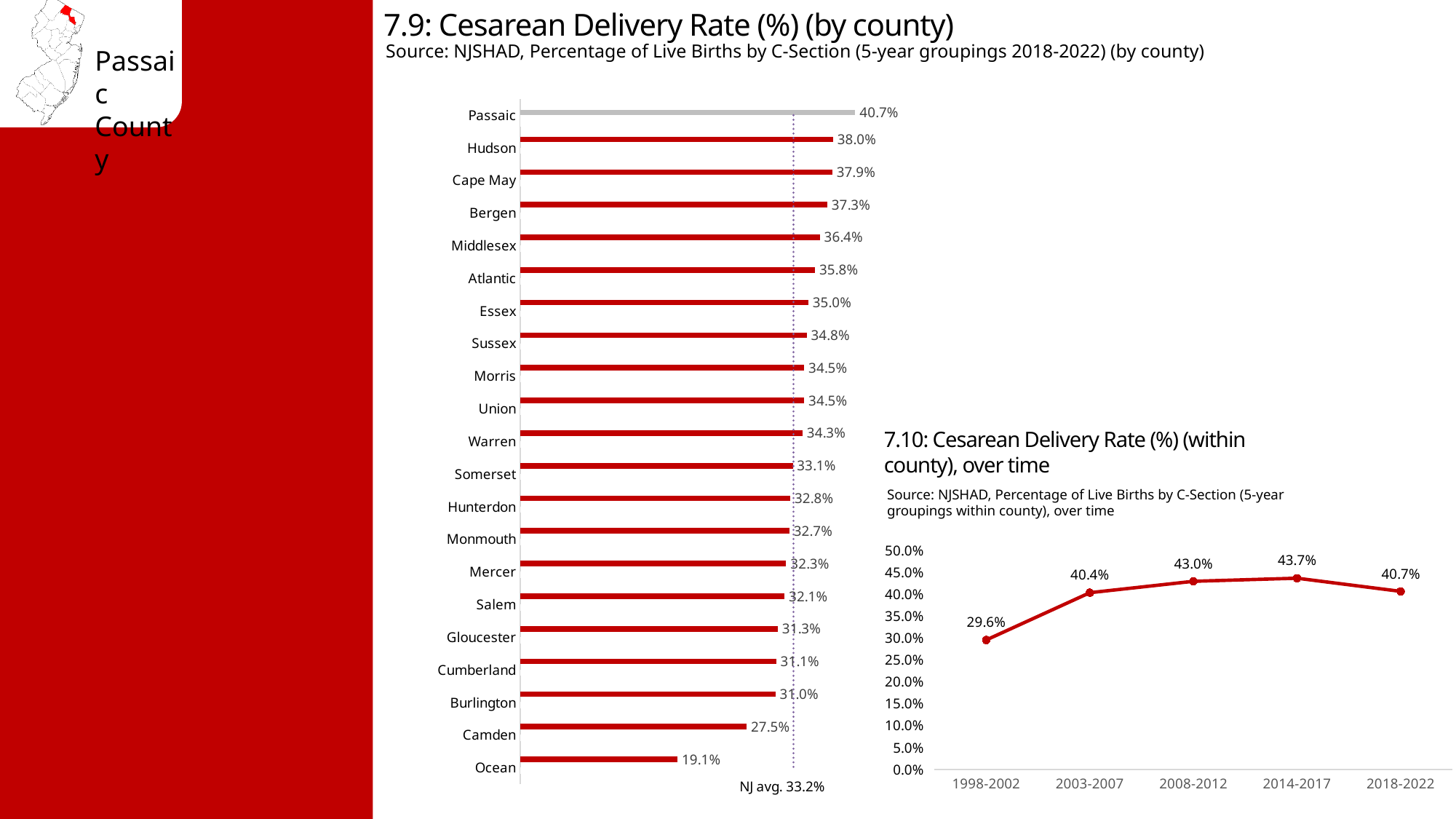
In chart 7.9 (Cesarean Delivery Rate by county), which county has the lowest rate? Ocean In chart 7.9 (Cesarean Delivery Rate by county), what NJ average is shown by the dotted line? 33.2% In chart 7.10 (Cesarean Delivery Rate within county, over time), what is the value for 2014-2017? 43.7% In chart 7.9 (Cesarean Delivery Rate by county), how many counties are shown? 21 What kind of chart is chart 7.10 (Cesarean Delivery Rate within county, over time)? line chart In chart 7.10 (Cesarean Delivery Rate within county, over time), what is the difference between 1998-2002 and 2003-2007? 10.8% In chart 7.9 (Cesarean Delivery Rate by county), what is the value for Passaic? 40.7% In chart 7.9 (Cesarean Delivery Rate by county), which county has the highest rate? Passaic In chart 7.9 (Cesarean Delivery Rate by county), what is the difference between Passaic and Ocean? 21.6% In chart 7.9 (Cesarean Delivery Rate by county), which is larger, Hudson or Bergen? Hudson In chart 7.10 (Cesarean Delivery Rate within county, over time), how many time periods are plotted? 5 In chart 7.9 (Cesarean Delivery Rate by county), what is the value for Camden? 27.5%